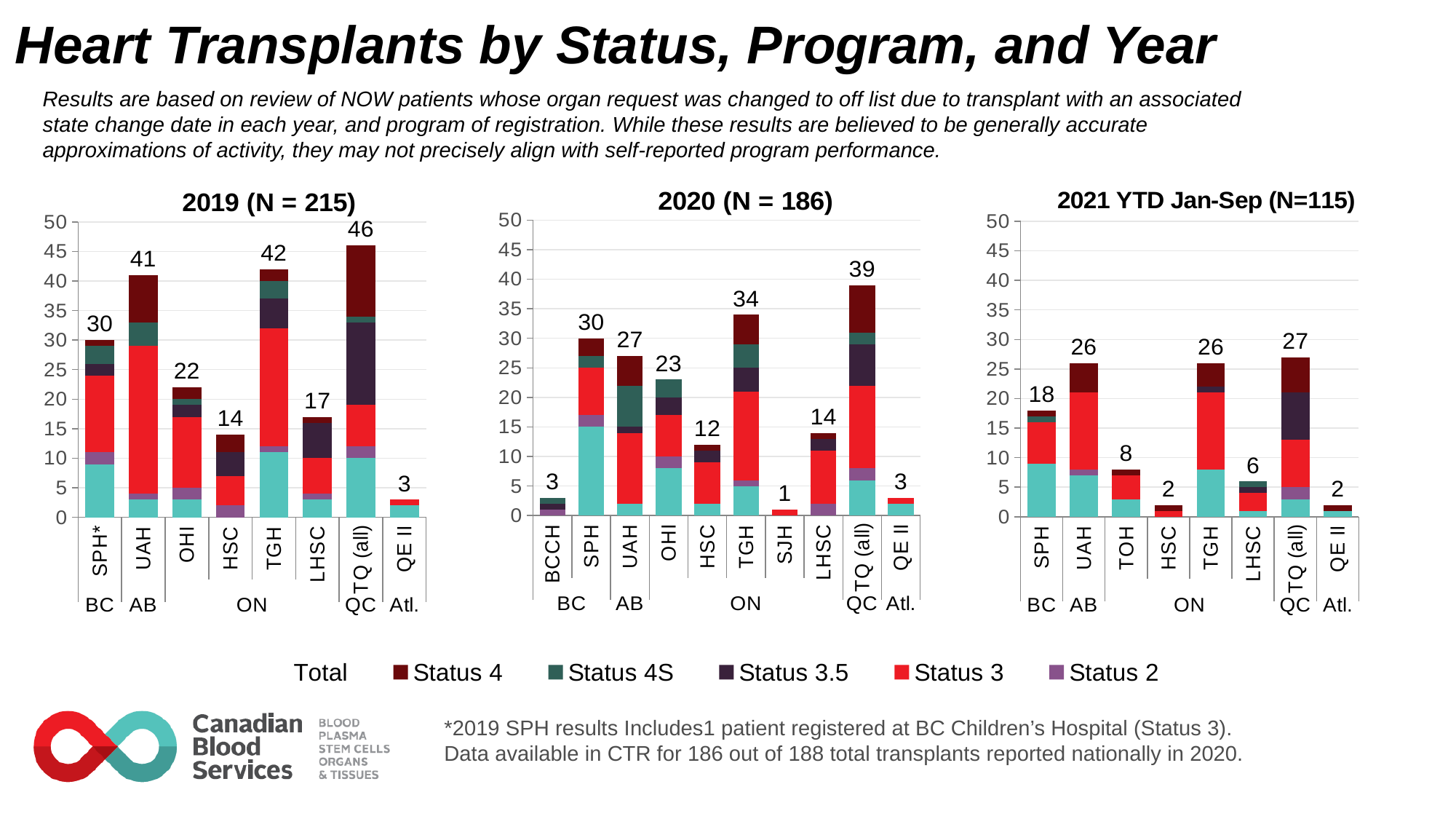
In the 2019 (N = 215) chart, what is the total for TQ (all)? 46 In the 2019 (N = 215) chart, which program has the highest total? TQ (all) In the 2020 (N = 186) chart, which program has the lowest total? SJH Which colour represents Status 3 in the legend? Red In the 2020 (N = 186) chart, what is the total for TGH? 34 In the 2021 YTD Jan-Sep (N=115) chart, what is the total for SPH? 18 In the 2019 (N = 215) chart, which is larger, the total for UAH or the total for OHI? UAH How many program bars are shown in the 2020 (N = 186) chart? 10 In the 2021 YTD Jan-Sep (N=115) chart, what is the difference between the totals for TQ (all) and TOH? 19 What kind of chart is the 2019 (N = 215) chart? Stacked bar chart In the 2020 (N = 186) chart, what is the difference between the totals for TQ (all) and UAH? 12 In the 2020 (N = 186) chart, is the Status 3 segment for SPH greater or less than 10? less